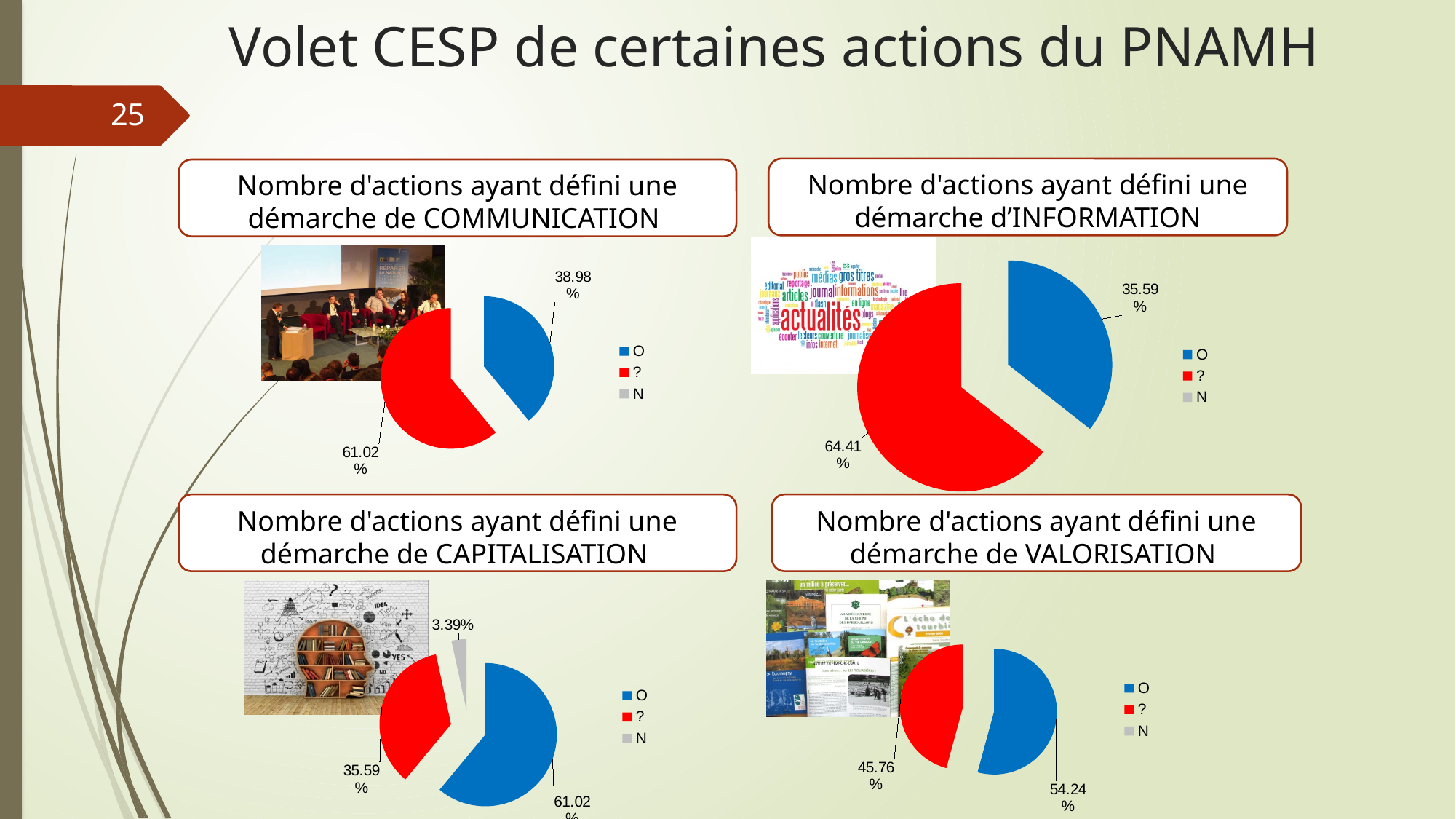
In the CAPITALISATION pie chart, what share is labelled for the 'N' slice? 3.39% In the VALORISATION pie chart, what share is labelled for the 'O' slice? 54.24% In the INFORMATION pie chart, what share is labelled for the '?' slice? 64.41% In the VALORISATION pie chart, what is the difference between the 'O' share and the '?' share? 8.48% In the COMMUNICATION pie chart, what share is labelled for the 'O' slice? 38.98% How many entries does the legend of the VALORISATION pie chart list? 3 In the INFORMATION pie chart, which slice is larger, 'O' or '?'? ? In the CAPITALISATION pie chart, which slice is the largest? O What type of chart is used for the COMMUNICATION data? Pie chart In the COMMUNICATION pie chart, what share is labelled for the '?' slice? 61.02% In the CAPITALISATION pie chart, which slice is the smallest? N In the INFORMATION pie chart, what share is labelled for the 'O' slice? 35.59%